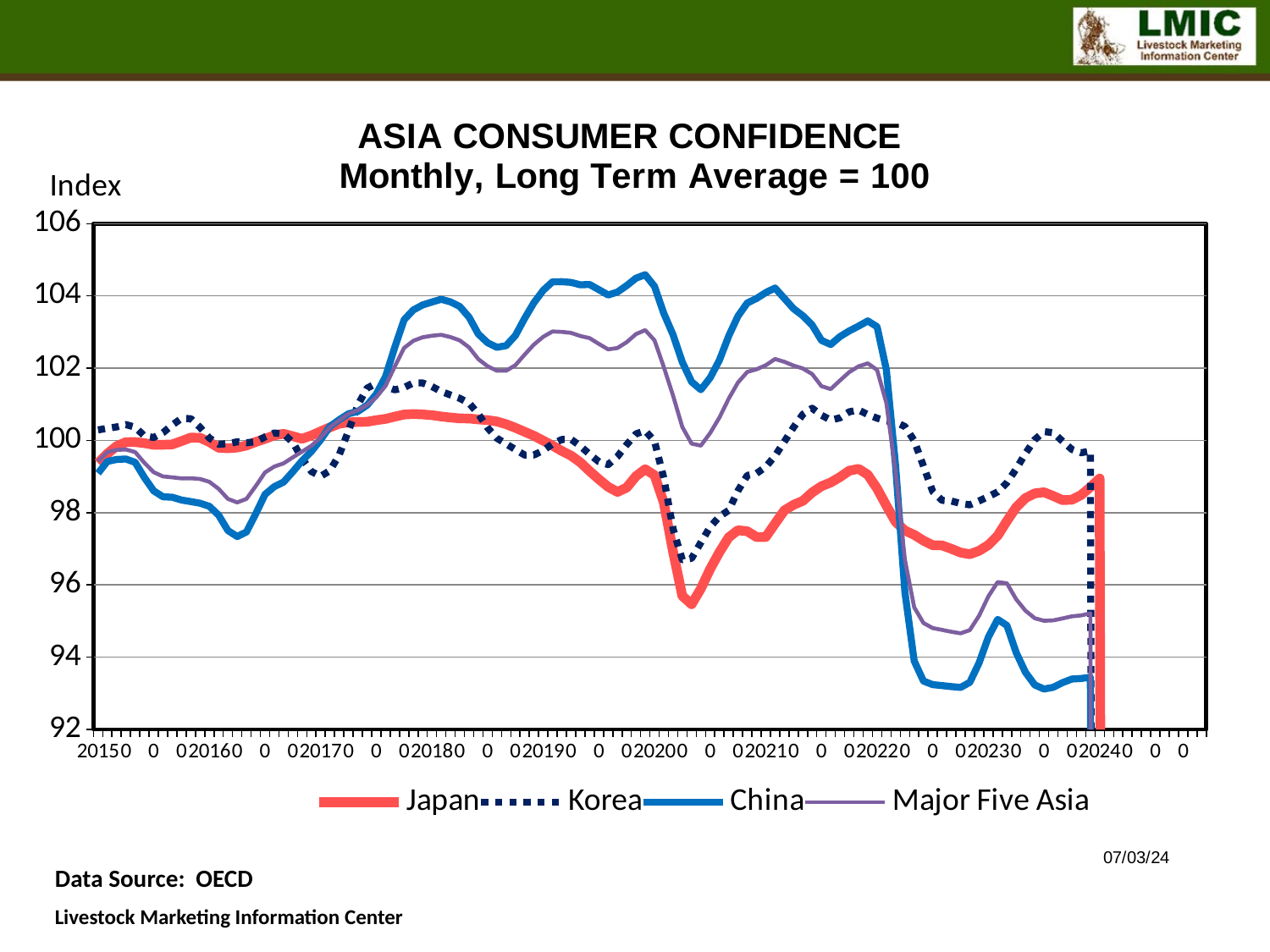
Which series falls to the lowest value anywhere on the chart? China What kind of chart is shown on the slide? Line chart Which series reaches the highest value anywhere on the chart? China Which series is the lowest at the right-hand end of the chart (2024)? China How many series does the legend list? 4 What is the title of the chart? ASIA CONSUMER CONFIDENCE Monthly, Long Term Average = 100 Around 2018 to 2019, is China above or below Japan? above Is the lowest value for Korea in 2020 greater or less than 98? less Does the China series rise or fall between 2022 and 2023? fall Is the lowest value for Japan in 2020 greater or less than 96? less Which series is drawn with a dotted line? Korea